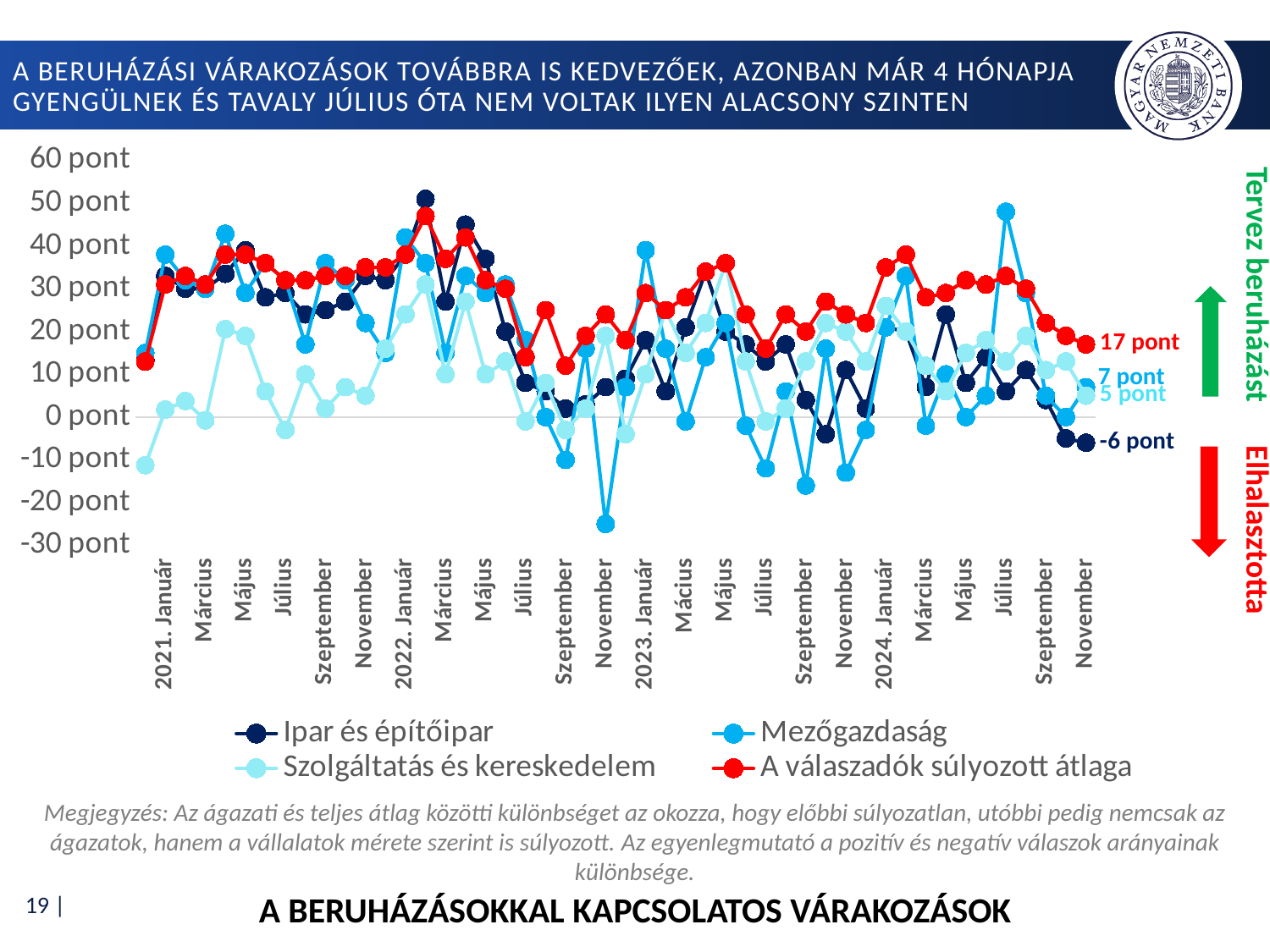
What is the value of 'Mezőgazdaság' at the last point (November 2024)? 7 pont How many series does the legend list? 4 At the last point (November 2024), which is larger: 'Mezőgazdaság' or 'Szolgáltatás és kereskedelem'? Mezőgazdaság What is the value of 'Szolgáltatás és kereskedelem' at the last point (November 2024)? 5 pont What kind of chart is shown on the slide? line chart What colour is the line for 'A válaszadók súlyozott átlaga'? red Which series has the highest value at the last point (November 2024)? A válaszadók súlyozott átlaga Is the value for 'Mezőgazdaság' in November 2022 greater or less than -20 pont? less What is the difference between the November 2024 values of 'A válaszadók súlyozott átlaga' and 'Ipar és építőipar'? 23 pont What is the value of 'Ipar és építőipar' at the last point (November 2024)? -6 pont Which series has the lowest value at the last point (November 2024)? Ipar és építőipar What is the value of 'A válaszadók súlyozott átlaga' at the last point (November 2024)? 17 pont